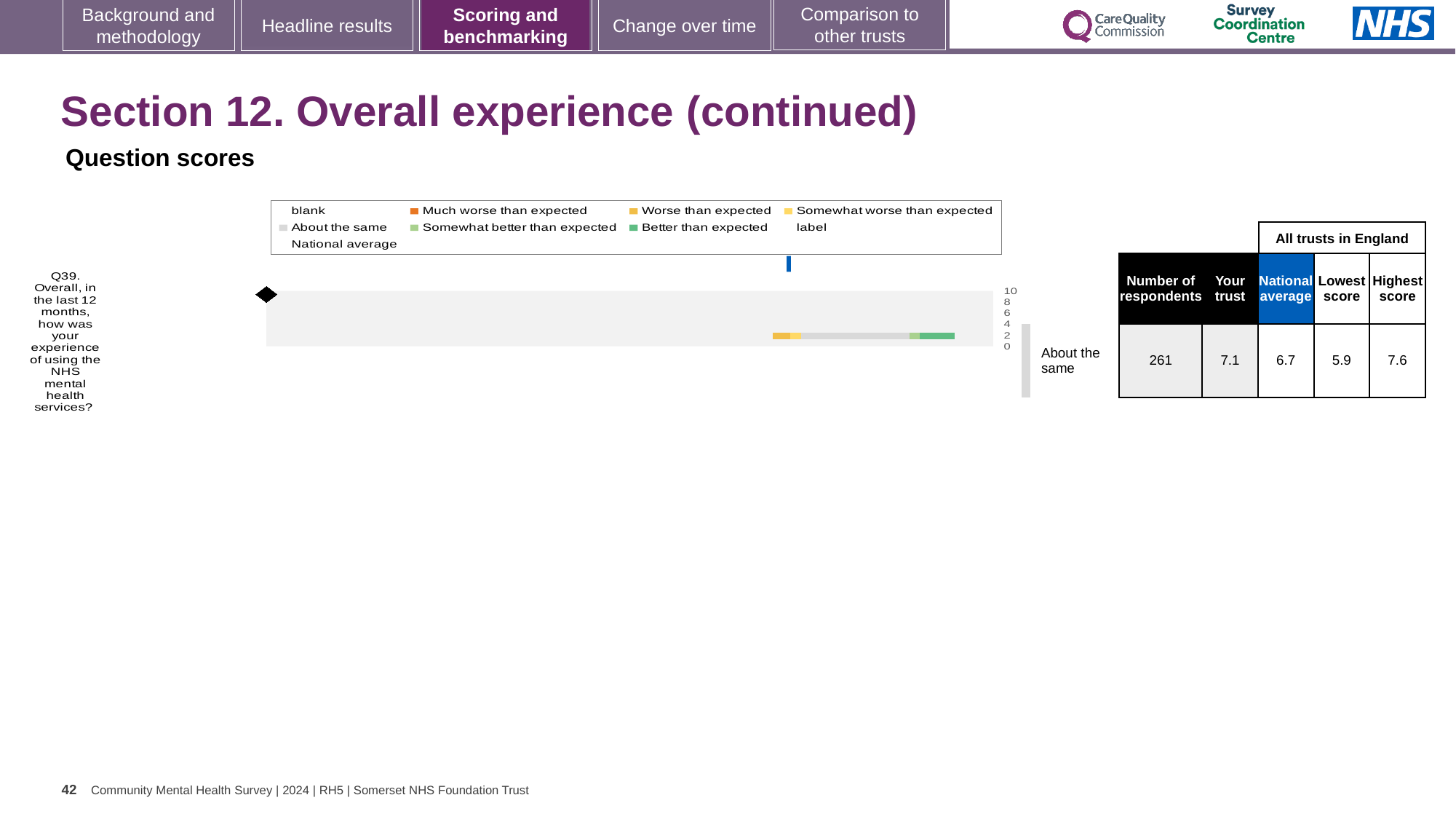
In the table next to the chart, what is the 'Your trust' score for Q39? 7.1 What benchmark category label is shown to the right of the Q39 bar? About the same How many survey questions are plotted in the chart? 1 In the table next to the chart, what is the highest score among all trusts in England for Q39? 7.6 In the table next to the chart, what is the national average score for Q39? 6.7 What is the difference between the 'Your trust' score and the national average for Q39? 0.4 Which is higher for Q39, the 'Your trust' score or the national average? Your trust Which question is plotted in the chart? Q39. Overall, in the last 12 months, how was your experience of using the NHS mental health services? Which legend entry is shown in dark green? Better than expected What kind of chart is shown on the slide for Q39? Bar chart In the table next to the chart, what is the number of respondents for Q39? 261 In the table next to the chart, what is the lowest score among all trusts in England for Q39? 5.9